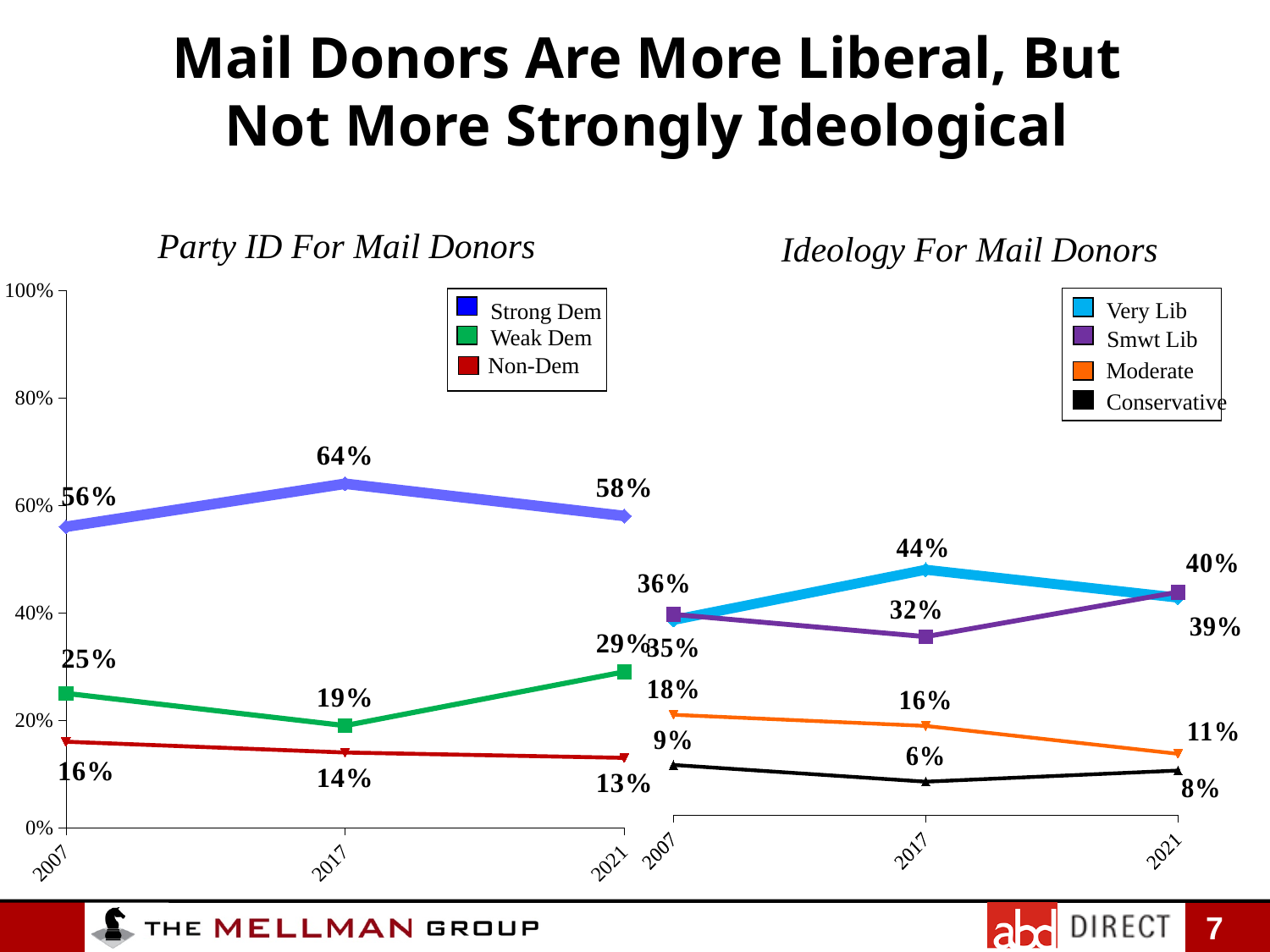
In the "Party ID For Mail Donors" chart, does the Non-Dem value rise or fall from 2007 to 2021? Fall In the "Ideology For Mail Donors" chart, in which year is the Conservative value lowest? 2017 In the "Ideology For Mail Donors" chart, what is the Moderate value for 2021? 11% In the "Ideology For Mail Donors" chart, what is the Very Lib value for 2017? 44% In the "Party ID For Mail Donors" chart, in which year is the Strong Dem value highest? 2017 What kind of chart is the "Party ID For Mail Donors" chart? Line chart In the "Party ID For Mail Donors" chart, what is the Weak Dem value for 2021? 29% In the "Party ID For Mail Donors" chart, what is the Strong Dem value for 2017? 64% In the "Party ID For Mail Donors" chart, by how many percentage points did Strong Dem rise from 2007 to 2017? 8 percentage points How many series does the legend of the "Ideology For Mail Donors" chart list? 4 How many series does the legend of the "Party ID For Mail Donors" chart list? 3 In the "Party ID For Mail Donors" chart, what is the Non-Dem value for 2007? 16%